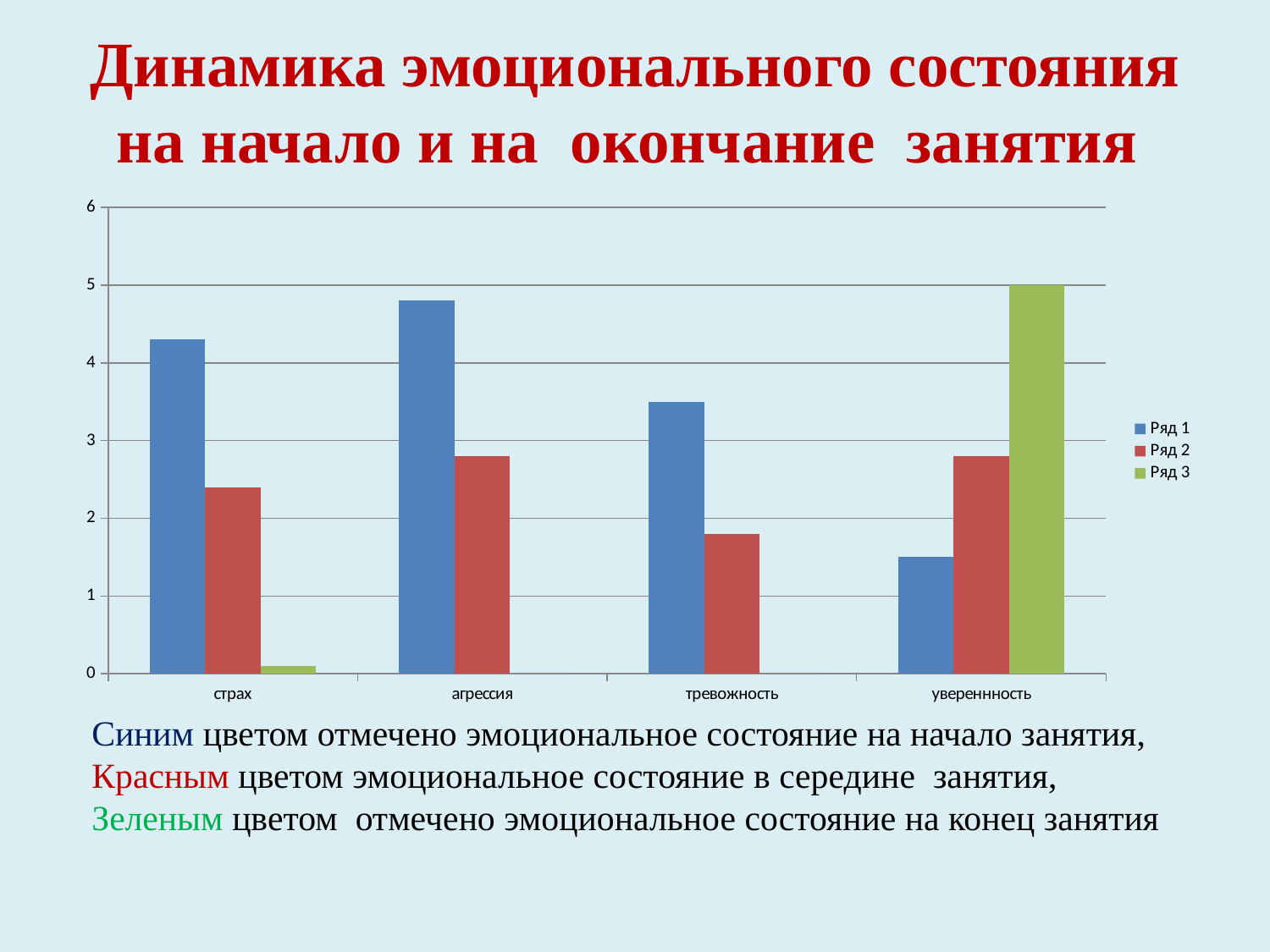
What is the value of Ряд 3 for уверенность? 5 Is the Ряд 2 value for тревожность greater or less than 2? less For уверенность, which is larger: the Ряд 1 value or the Ряд 2 value? Ряд 2 What kind of chart is shown on the slide? bar chart For which category is the Ряд 2 value lowest? тревожность Which colour represents Ряд 3 in the legend? green For which category is the Ряд 1 value lowest? уверенность Is the Ряд 1 value for страх greater or less than 4? greater How many series does the legend list? 3 How many categories are shown on the x axis? 4 For which category is the Ряд 1 value highest? агрессия Is the Ряд 1 value for тревожность greater or less than 3? greater